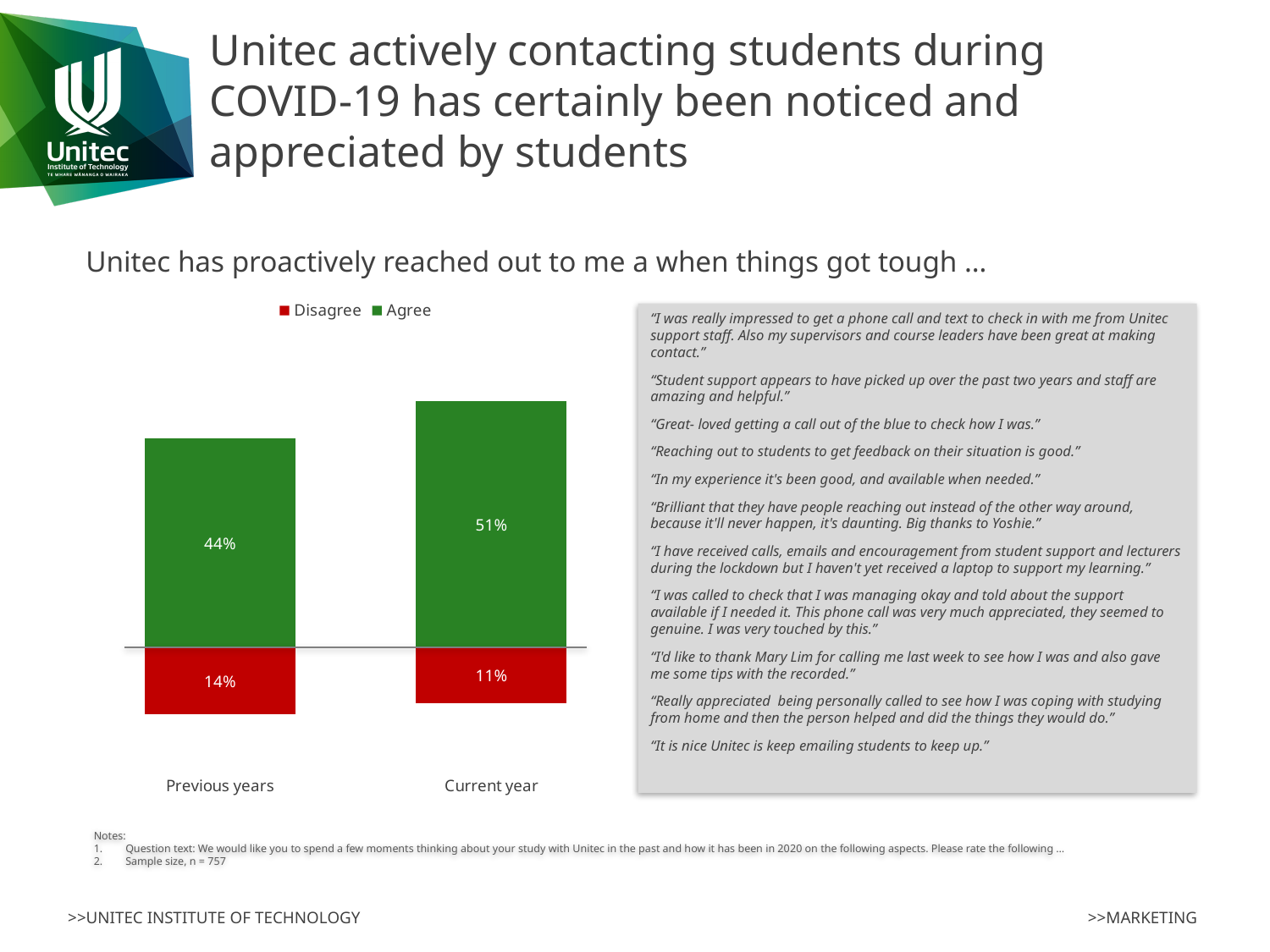
What is the Agree value for Current year? 51% What is the Agree value for Previous years? 44% Which category has the lower Disagree value? Current year How many series does the chart legend list? 2 What is the Disagree value for Previous years? 14% What kind of chart is shown on the slide? bar chart What is the Disagree value for Current year? 11% How many categories are shown on the x axis of the chart? 2 What is the difference between the Agree values for Current year and Previous years? 7% What is the difference between the Disagree values for Previous years and Current year? 3% Is the Agree value for Previous years larger or smaller than the Agree value for Current year? smaller Which category has the higher Agree value? Current year